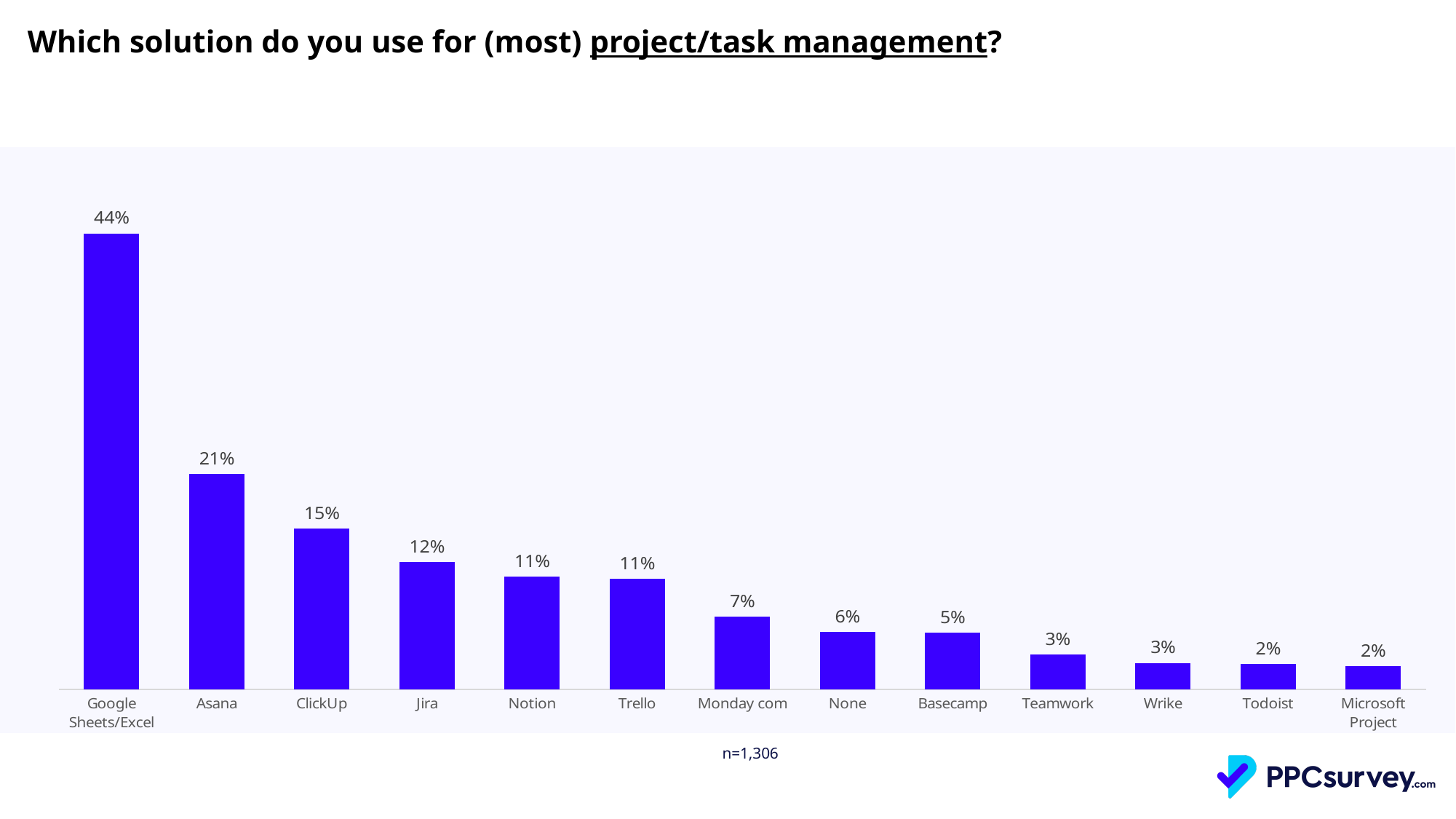
What percentage is shown for Monday com? 7% Which has a larger value, None or Basecamp? None What is the difference between the values for Google Sheets/Excel and Asana? 23% What percentage of respondents use Google Sheets/Excel for project/task management? 44% What is the sample size (n) noted below the chart? n=1,306 What is the difference between the values for ClickUp and Jira? 3% What is the value shown for Asana? 21% Which solution has the highest percentage? Google Sheets/Excel Which has a larger value, Asana or ClickUp? Asana How many solution categories are shown on the chart? 13 What kind of chart is shown on the slide? Bar chart What is the value for Basecamp? 5%